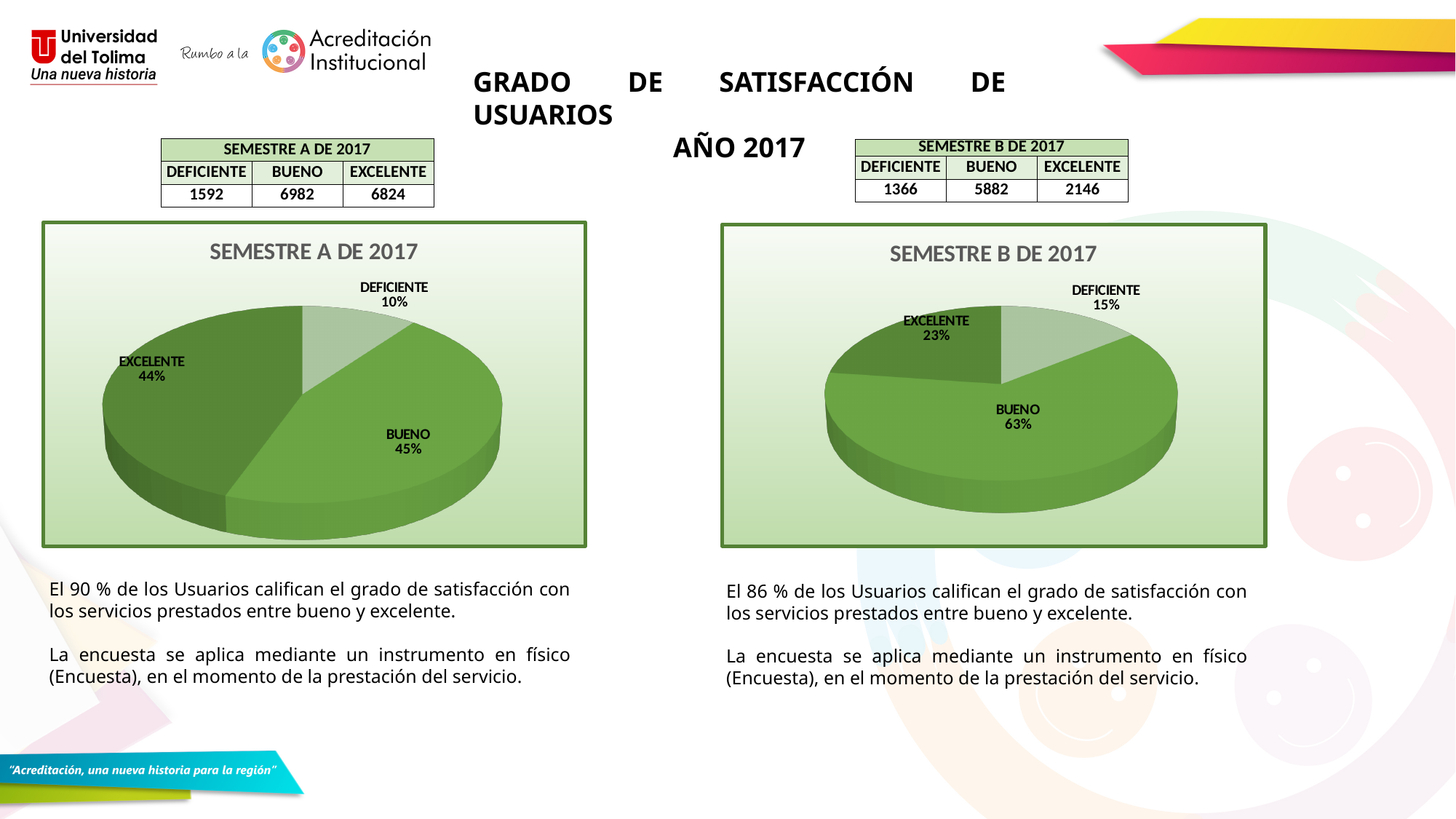
In the 'SEMESTRE A DE 2017' chart, what percentage is shown for BUENO? 45% In the 'SEMESTRE A DE 2017' chart, what is the difference in percentage points between EXCELENTE and DEFICIENTE? 34 In the 'SEMESTRE A DE 2017' chart, which category has the smallest slice? DEFICIENTE In the 'SEMESTRE B DE 2017' chart, what percentage is shown for EXCELENTE? 23% In the 'SEMESTRE B DE 2017' chart, which is larger, EXCELENTE or DEFICIENTE? EXCELENTE In the 'SEMESTRE A DE 2017' chart, what percentage is shown for DEFICIENTE? 10% In the 'SEMESTRE B DE 2017' chart, which category has the largest slice? BUENO How many slices does the 'SEMESTRE A DE 2017' chart have? 3 In the 'SEMESTRE B DE 2017' chart, what percentage is shown for BUENO? 63% What type of chart is 'SEMESTRE B DE 2017'? Pie chart In the 'SEMESTRE B DE 2017' chart, what is the difference in percentage points between BUENO and EXCELENTE? 40 In the 'SEMESTRE B DE 2017' chart, which category has the smallest slice? DEFICIENTE